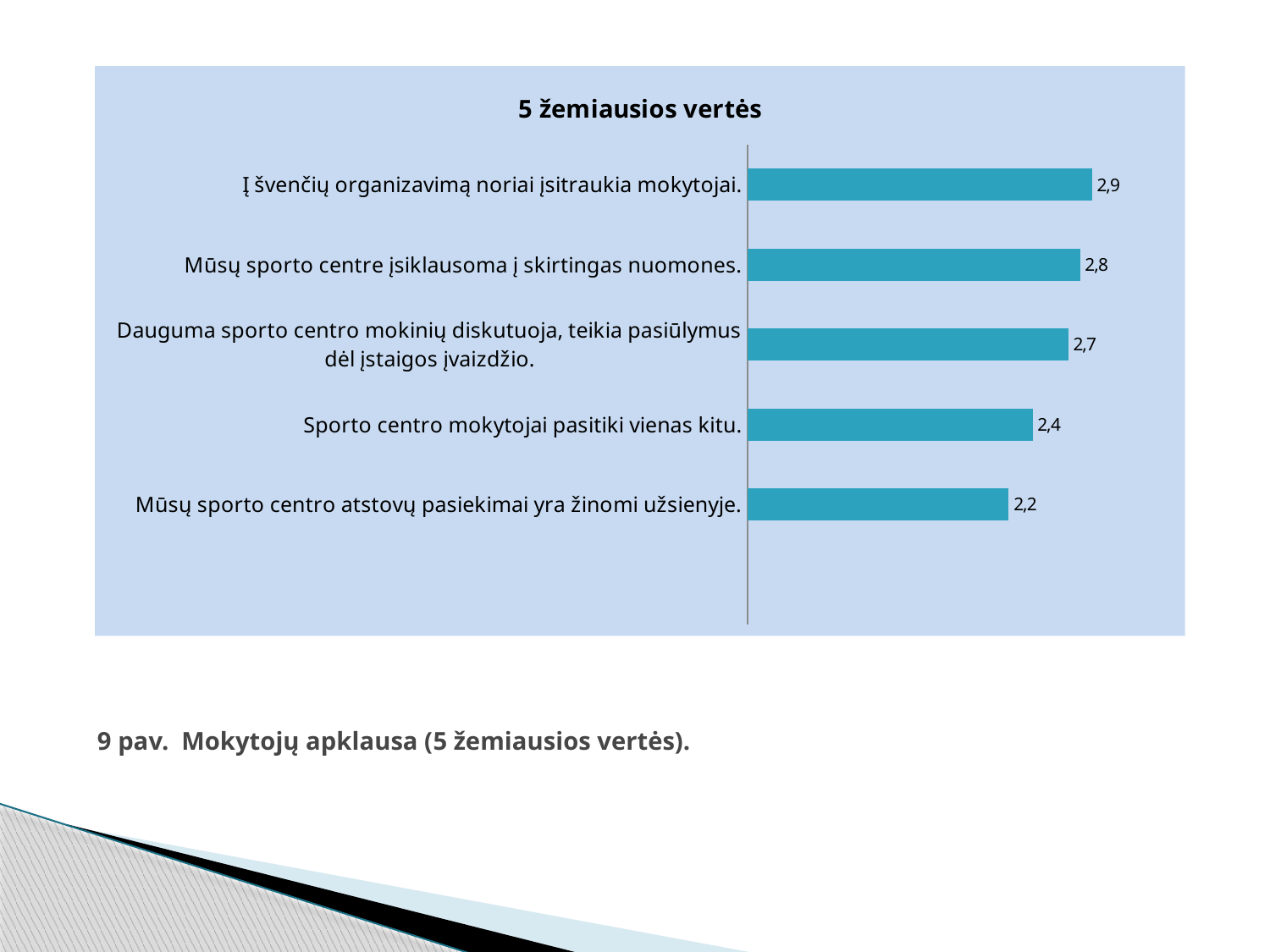
What is the value for "Dauguma sporto centro mokinių diskutuoja, teikia pasiūlymus dėl įstaigos įvaizdžio."? 2,7 What is the difference between the values for "Į švenčių organizavimą noriai įsitraukia mokytojai." and "Mūsų sporto centro atstovų pasiekimai yra žinomi užsienyje."? 0,7 What is the title of the chart? 5 žemiausios vertės What is the value for "Sporto centro mokytojai pasitiki vienas kitu."? 2,4 What is the value for "Mūsų sporto centro atstovų pasiekimai yra žinomi užsienyje."? 2,2 How many categories are shown in the chart? 5 What is the difference between the values for "Mūsų sporto centre įsiklausoma į skirtingas nuomones." and "Sporto centro mokytojai pasitiki vienas kitu."? 0,4 Which category has the highest value? Į švenčių organizavimą noriai įsitraukia mokytojai. What kind of chart is shown on the slide? Bar chart Which category has the lowest value? Mūsų sporto centro atstovų pasiekimai yra žinomi užsienyje. Which is larger: the value for "Mūsų sporto centre įsiklausoma į skirtingas nuomones." or for "Sporto centro mokytojai pasitiki vienas kitu."? Mūsų sporto centre įsiklausoma į skirtingas nuomones. What is the value for "Į švenčių organizavimą noriai įsitraukia mokytojai."? 2,9